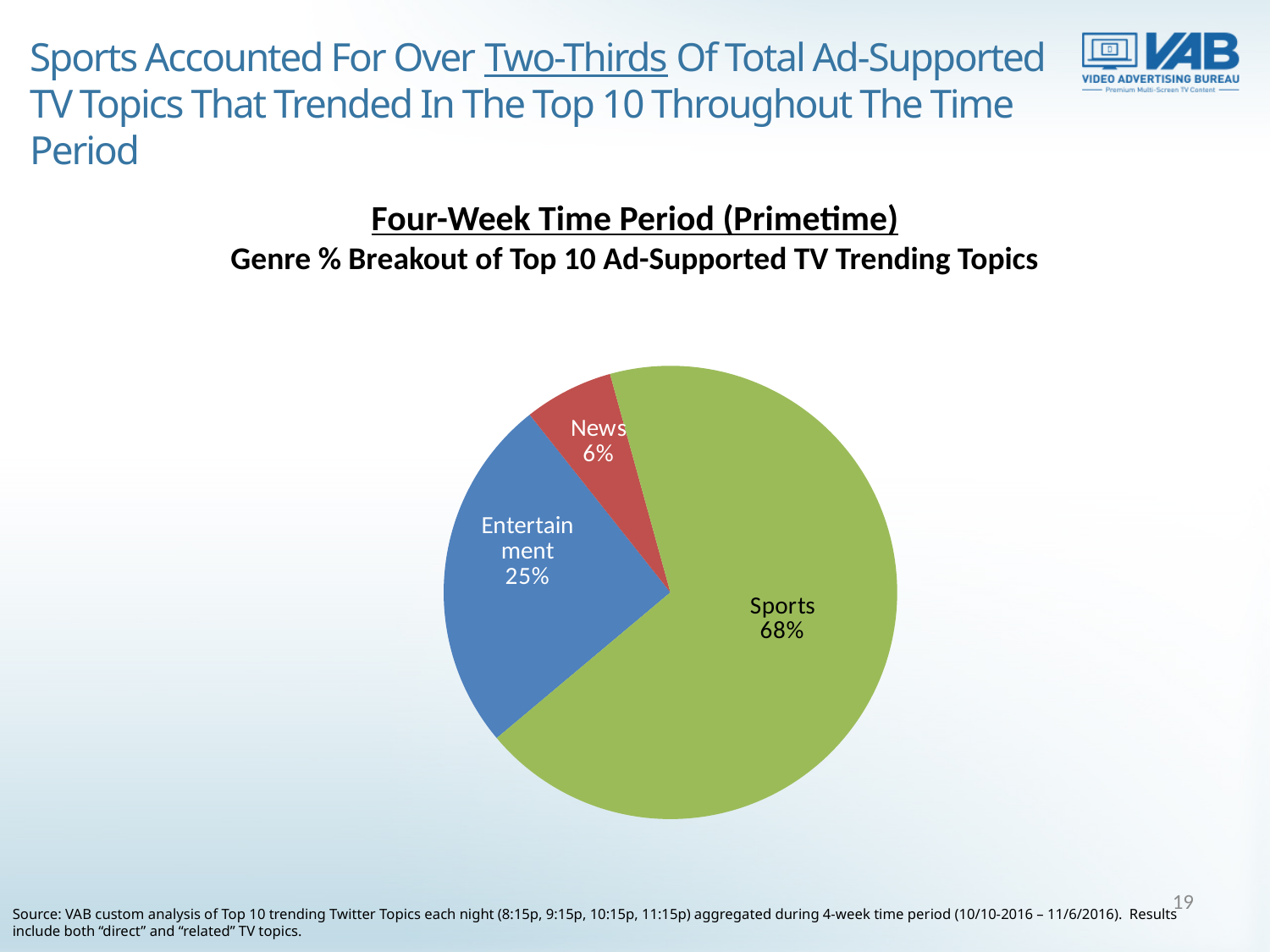
Which slice is larger, Entertainment or News? Entertainment Which genre has the smallest share of the pie? News What percentage of the pie does News account for? 6% How many slices does the pie chart have? 3 What kind of chart is shown on the slide? Pie chart What percentage of the pie does Entertainment account for? 25% Which genre has the largest share of the pie? Sports What is the difference in percentage points between the Entertainment and News slices? 19 What colour is the Sports slice of the pie? Green What is the title shown directly above the pie chart? Genre % Breakout of Top 10 Ad-Supported TV Trending Topics What percentage of the pie does Sports account for? 68% What is the difference in percentage points between the Sports and Entertainment slices? 43